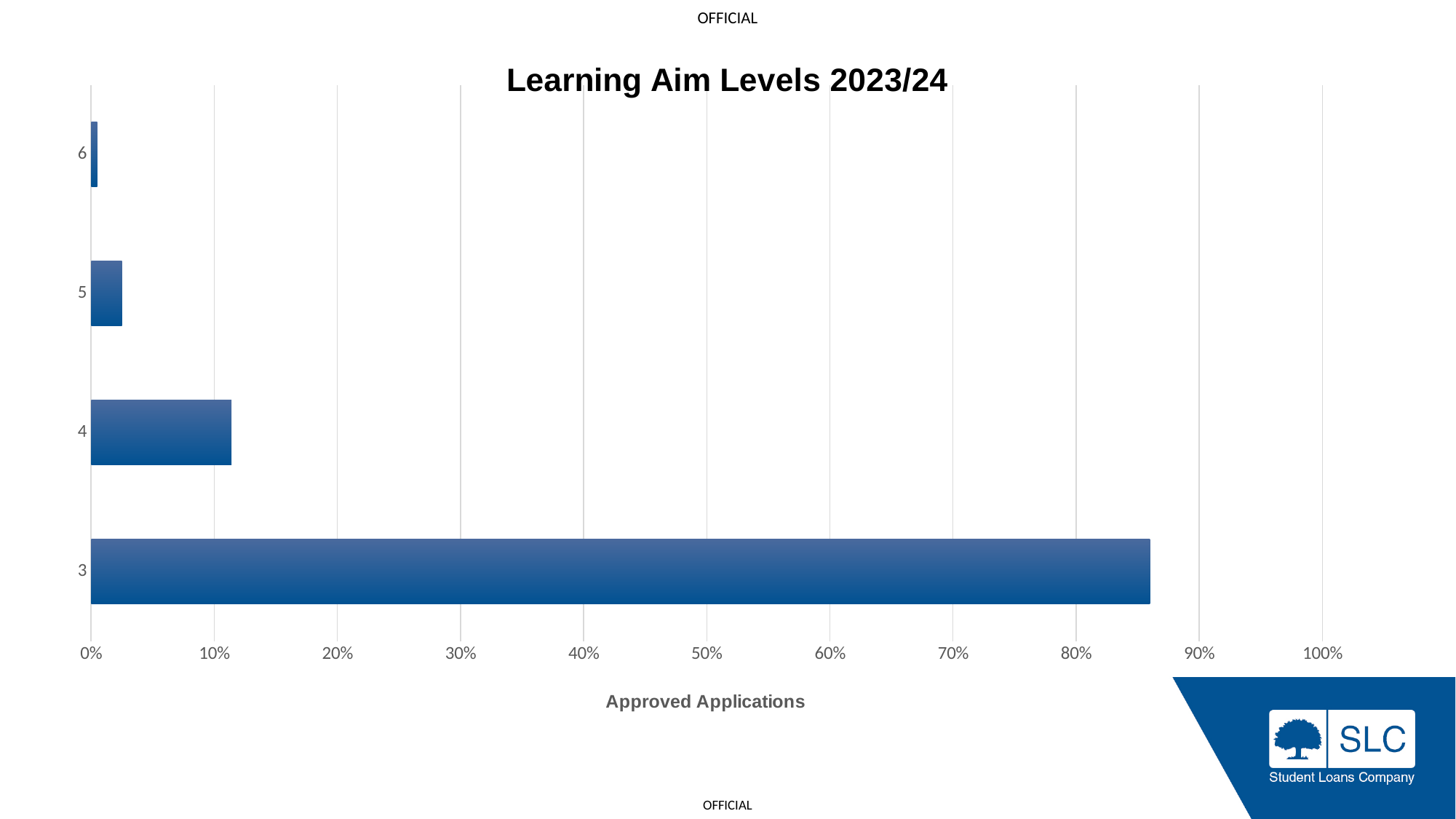
Which learning aim level has the highest share of approved applications? 3 Is the value for level 3 greater or less than 90%? less Which has a larger value, level 5 or level 6? level 5 How many learning aim levels are plotted in the chart? 4 What is the title of the chart? Learning Aim Levels 2023/24 Which learning aim level has the lowest share of approved applications? 6 What kind of chart is shown on the slide? bar chart Is the value for level 3 greater or less than 80%? greater Which has a larger value, level 4 or level 5? level 4 Is the value for level 4 greater or less than 10%? greater What is the label on the horizontal axis of the chart? Approved Applications